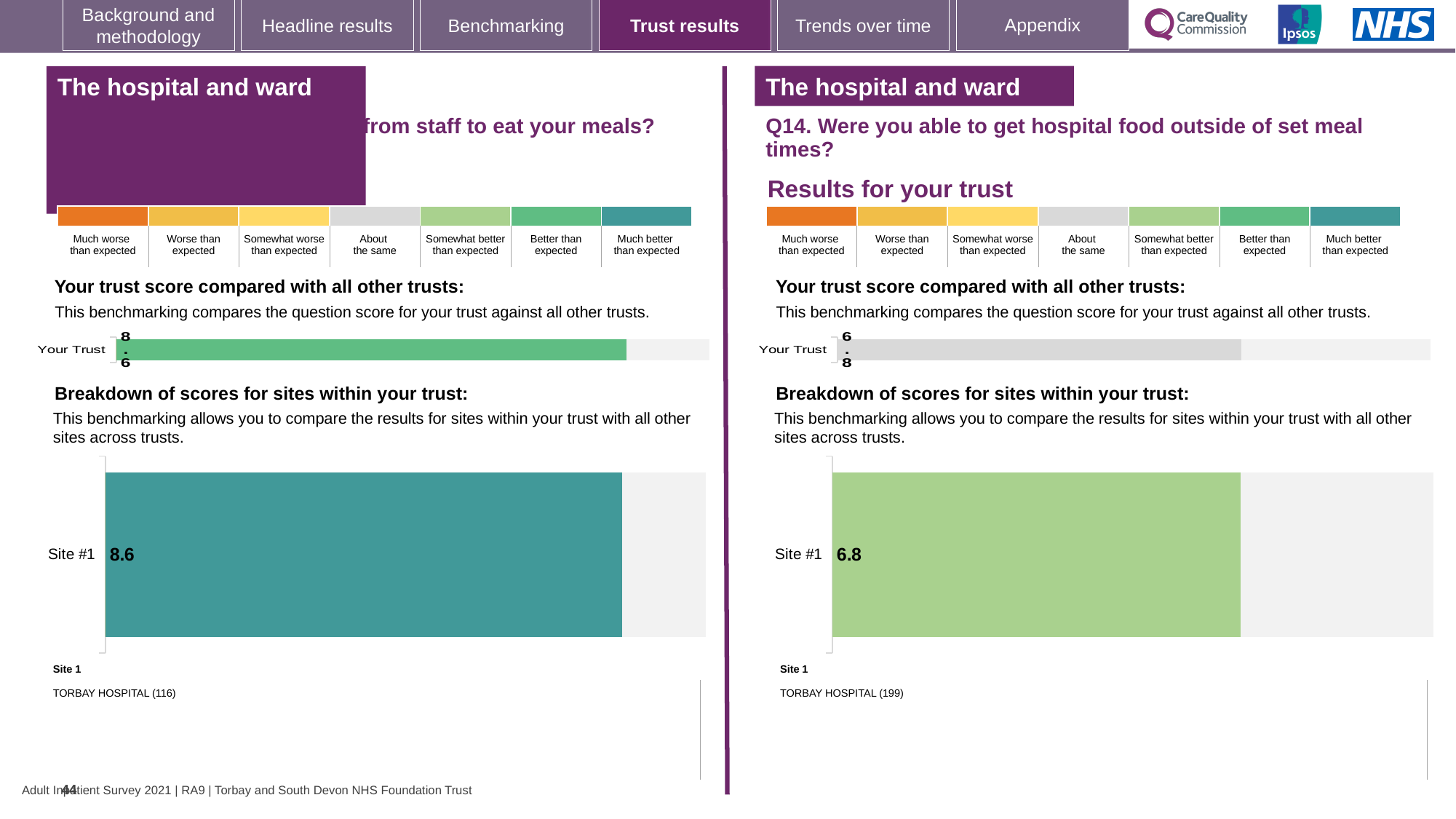
How many sites are plotted in the 'Breakdown of scores for sites within your trust' chart on the right half of the slide (Q14)? 1 Which Site #1 score is larger: the one in the left-hand breakdown chart or the one in the right-hand (Q14) breakdown chart? The left-hand chart (8.6) Which site name is listed under 'Site 1' on the left half of the slide? TORBAY HOSPITAL (116) What type of chart is used to show the Site #1 score in the 'Breakdown of scores for sites within your trust' section on the right half of the slide? Bar chart On the left half of the slide, what value is shown for 'Your Trust' in the 'Your trust score compared with all other trusts' chart? 8.6 How many sites are plotted in the 'Breakdown of scores for sites within your trust' chart on the left half of the slide? 1 On the right half of the slide (Q14), what is the score shown for Site #1 in the 'Breakdown of scores for sites within your trust' chart? 6.8 Is the Site #1 score in the right-hand (Q14) breakdown chart greater or less than the Site #1 score in the left-hand breakdown chart? less What is the difference between the Site #1 score in the left-hand breakdown chart and the Site #1 score in the right-hand (Q14) breakdown chart? 1.8 Which site name is listed under 'Site 1' on the right half of the slide (Q14)? TORBAY HOSPITAL (199) On the left half of the slide, what is the score shown for Site #1 in the 'Breakdown of scores for sites within your trust' chart? 8.6 On the right half of the slide (Q14), what value is shown for 'Your Trust' in the 'Your trust score compared with all other trusts' chart? 6.8